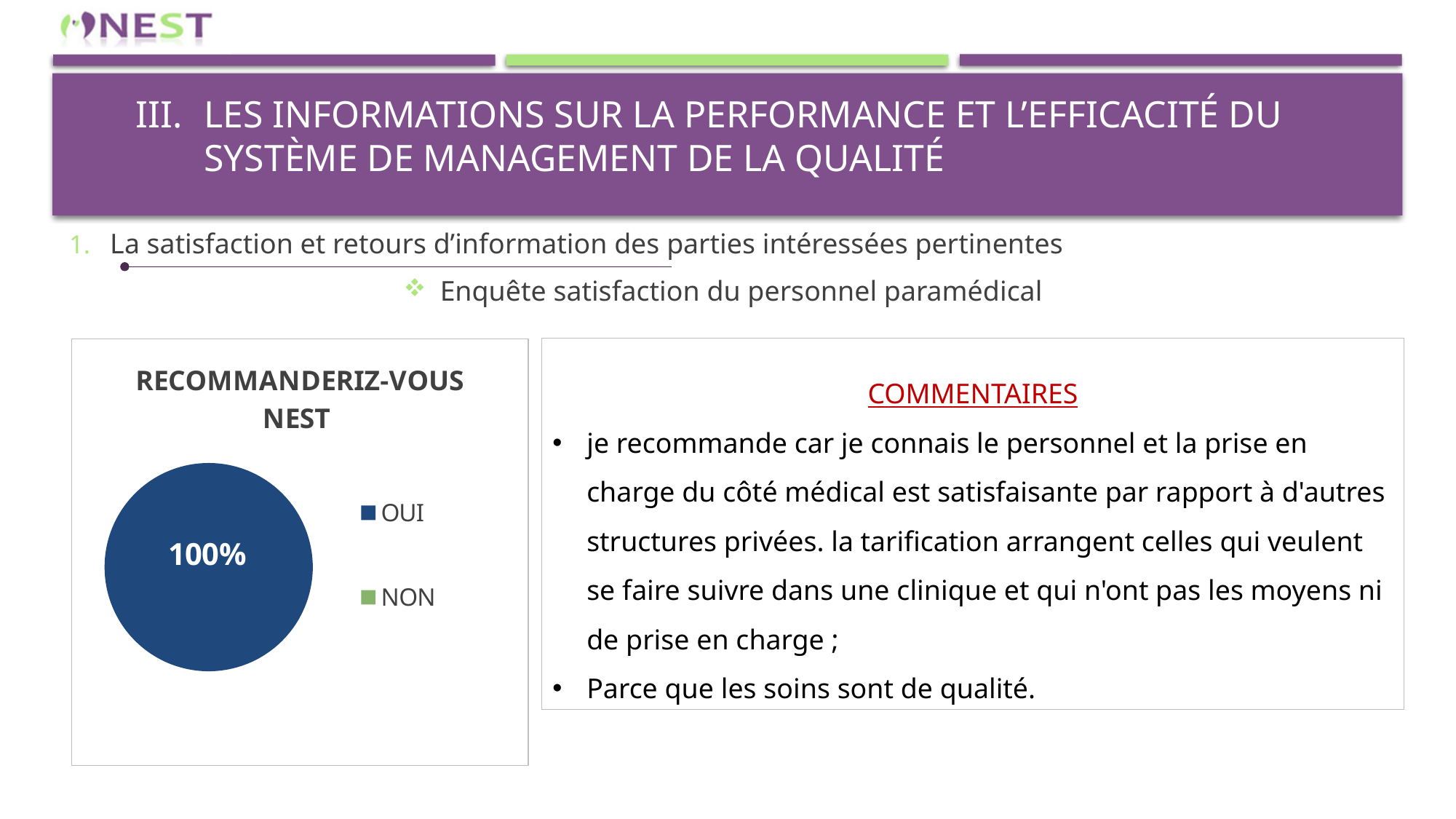
What is the title of the pie chart? RECOMMANDERIZ-VOUS NEST How many entries does the legend of the pie chart list? 2 Which legend entry is shown in blue in the pie chart? OUI What kind of chart is shown under the title "RECOMMANDERIZ-VOUS NEST"? pie chart Which category has the largest share of the pie chart? OUI Which of OUI or NON has the larger share of the pie chart? OUI What share of the pie does the OUI slice represent? 100% What is the value shown for OUI in the pie chart? 100%